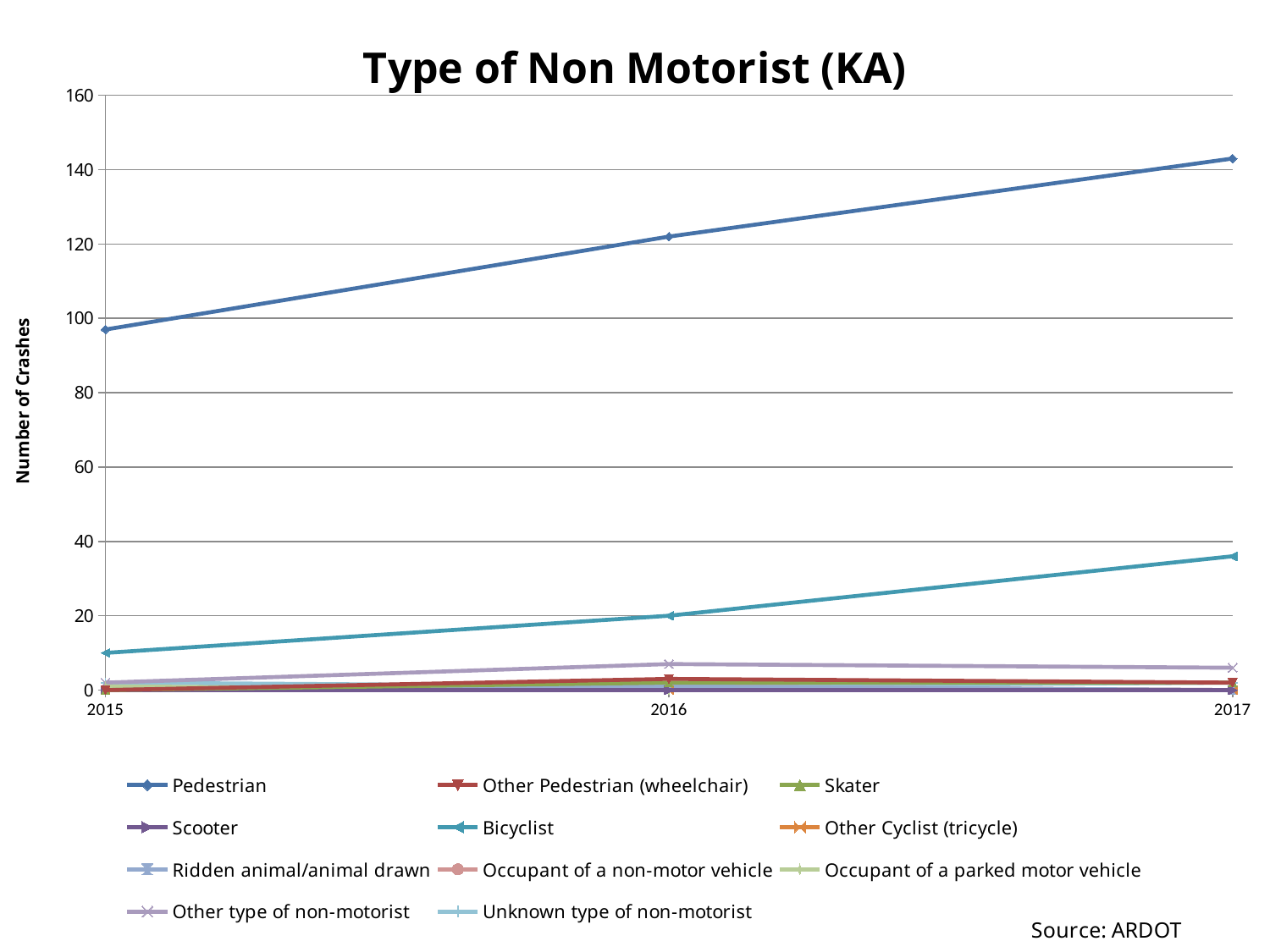
How many series does the legend list? 11 Is the value for Pedestrian in 2015 greater or less than 100? less In 2016, which is larger: Pedestrian or Bicyclist? Pedestrian Does the Bicyclist line rise or fall from 2015 to 2017? rise How many years are shown on the x axis? 3 Which series has the highest value in 2017? Pedestrian Is the value for Bicyclist in 2017 greater or less than 40? less Is the value for Pedestrian in 2017 greater or less than 140? greater Does the Pedestrian line rise or fall from 2015 to 2017? rise What is the label of the y axis? Number of Crashes What kind of chart is shown on the slide? line chart